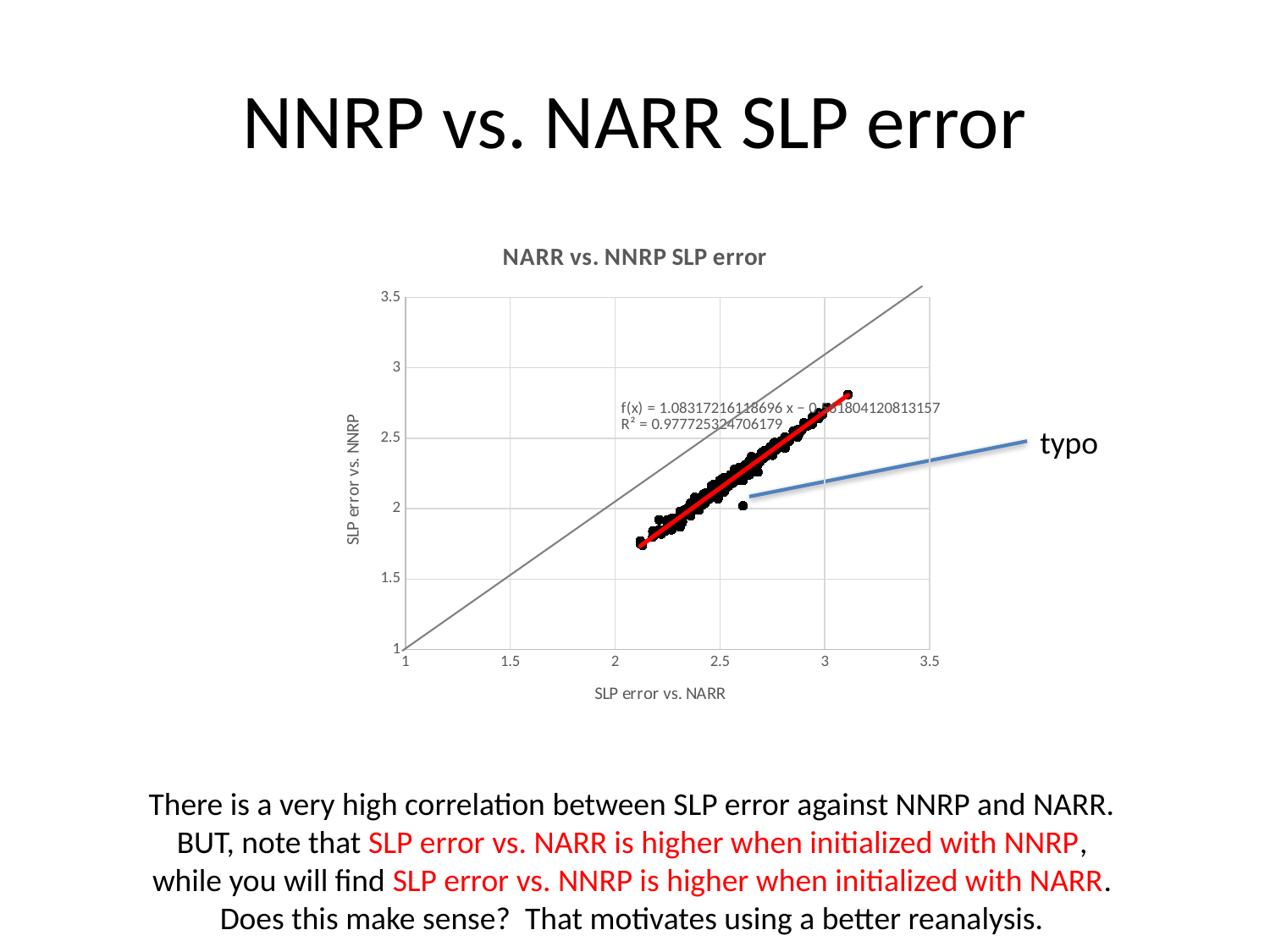
What is the label of the x axis of the chart? SLP error vs. NARR What R² value is printed on the chart for the fitted trendline? 0.977725324706179 What is the slope (coefficient of x) in the trendline equation printed on the chart? 1.08317216118696 Is the SLP error vs. NNRP value for the highest plotted point (near x = 3.1) greater or less than 2.5? greater Is the SLP error vs. NNRP value for the point marked as a typo greater or less than 2.5? less What kind of chart is shown on the slide? scatter chart As SLP error vs. NARR increases along the x axis, does SLP error vs. NNRP rise or fall? rise Is the SLP error vs. NNRP value for the lowest plotted point (near x = 2.1) greater or less than 2? less What is the title of the chart? NARR vs. NNRP SLP error